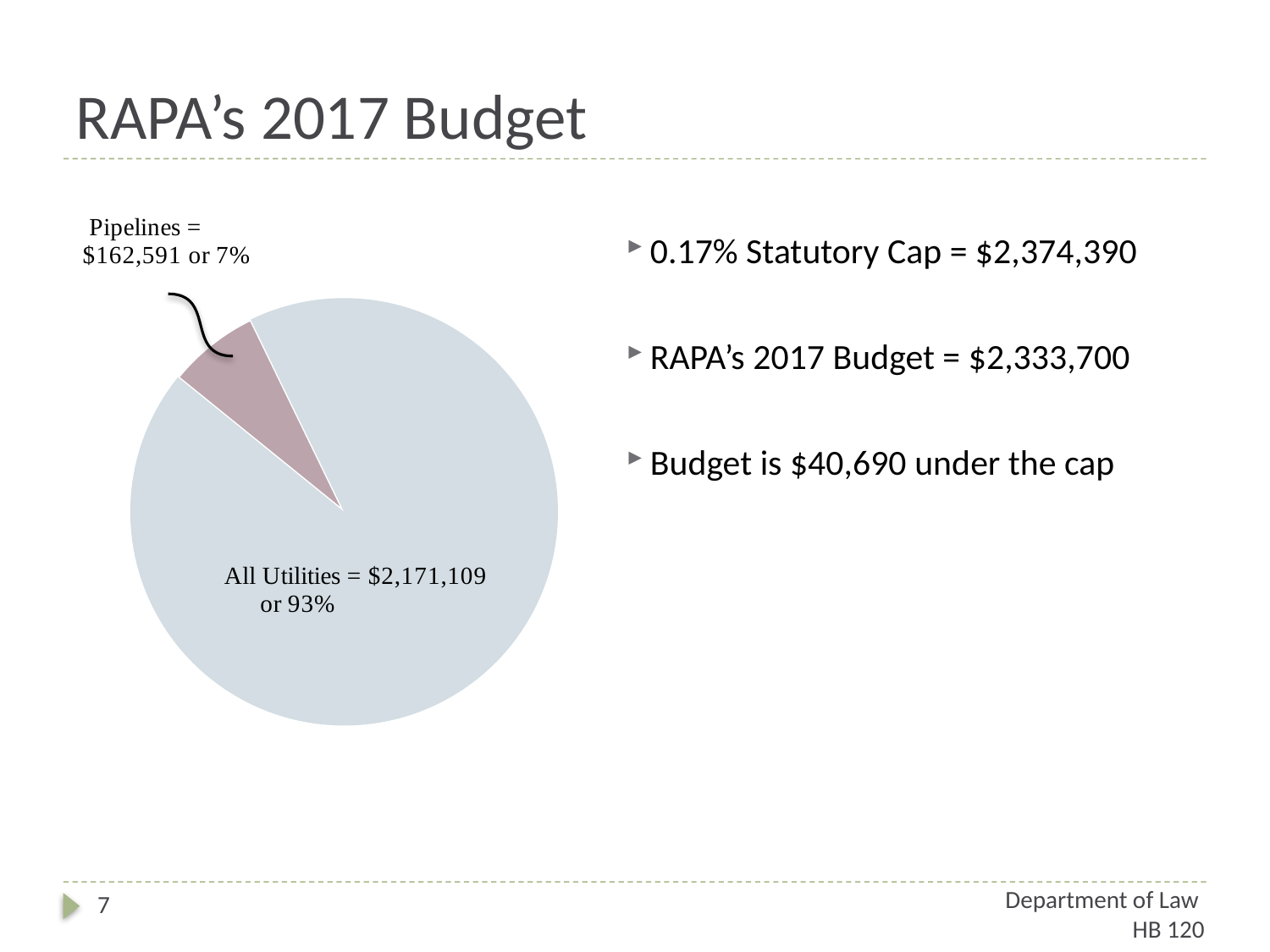
What type of chart is shown on the slide? pie chart What is the value for All Utilities in the pie chart? $2,171,109 How many slices does the pie chart have? 2 Which is larger, the value for All Utilities or the value for Pipelines? All Utilities Which slice of the pie chart is the smallest? Pipelines What is the value for Pipelines in the pie chart? $162,591 What share of the pie does All Utilities represent? 93% What colour is the Pipelines slice in the pie chart? mauve (pinkish-brown) Which slice of the pie chart is the largest? All Utilities What is the difference between the All Utilities value and the Pipelines value? $2,008,518 What is the total of the two slices in the pie chart? $2,333,700 What share of the pie does Pipelines represent? 7%